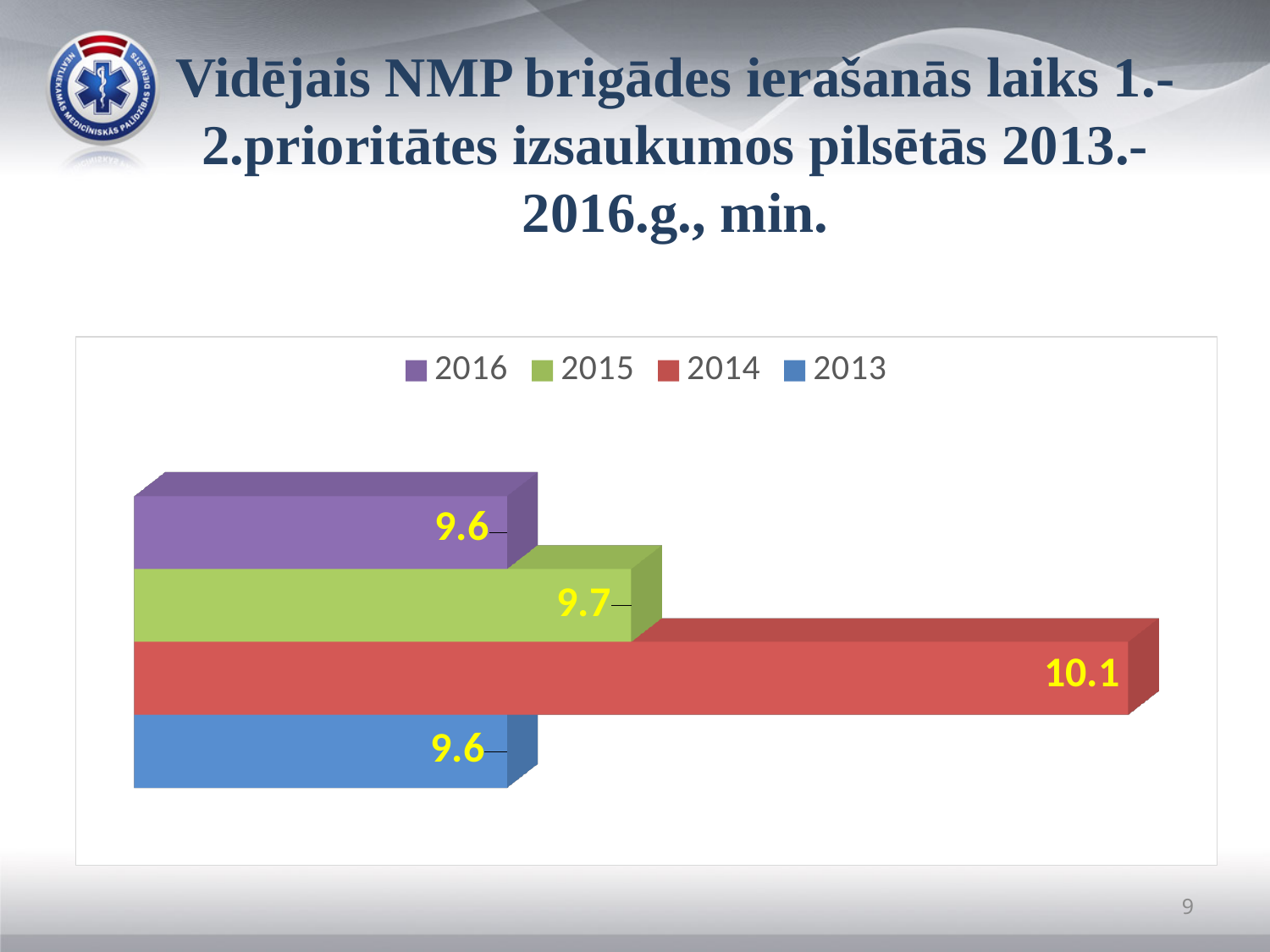
Which is larger, the value for 2015 or the value for 2016? 2015 What is the difference between the values for 2014 and 2013? 0.5 What is the value for 2014? 10.1 What is the value for 2016? 9.6 How many series does the legend list? 4 What is the difference between the values for 2014 and 2015? 0.4 Which colour represents 2014 in the legend? Red Which year has the highest value? 2014 How many bars are plotted in the chart? 4 What is the value for 2013? 9.6 What is the value for 2015? 9.7 What kind of chart is shown on the slide? Bar chart